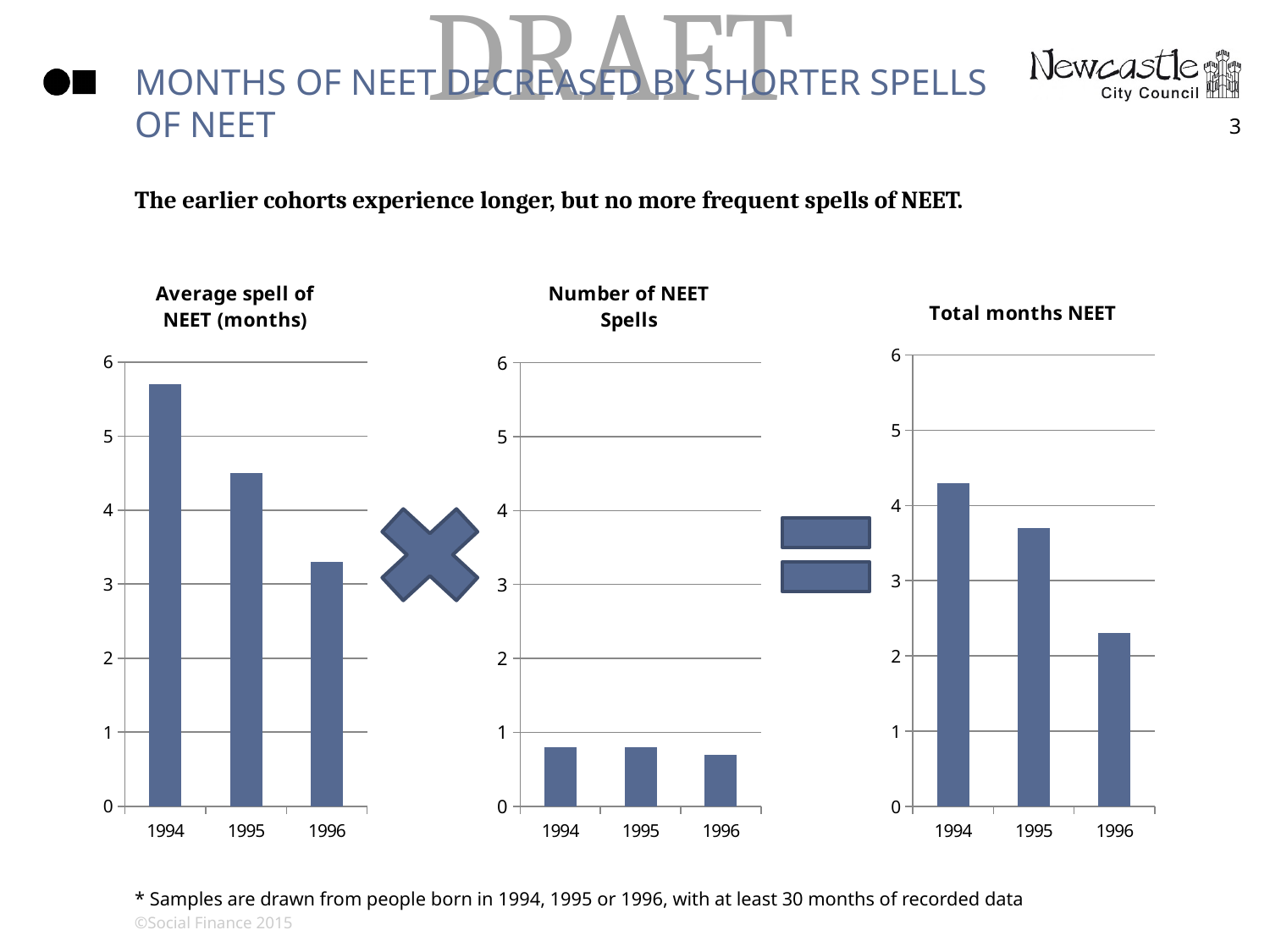
In the 'Total months NEET' chart, which year has the highest value? 1994 In the 'Average spell of NEET (months)' chart, which year has the highest value? 1994 How many charts are shown on the slide? 3 How many years are shown on the x axis of the 'Number of NEET Spells' chart? 3 In the 'Total months NEET' chart, is the value for 1996 greater or less than 3? less In the 'Number of NEET Spells' chart, is the value for 1994 greater or less than 1? less In the 'Average spell of NEET (months)' chart, is the value for 1996 greater or less than 4? less What kind of chart is the 'Total months NEET' chart? bar chart In the 'Average spell of NEET (months)' chart, which year has the lowest value? 1996 In the 'Average spell of NEET (months)' chart, do the values rise or fall from 1994 to 1996? fall In the 'Total months NEET' chart, which is larger, the value for 1995 or the value for 1996? 1995